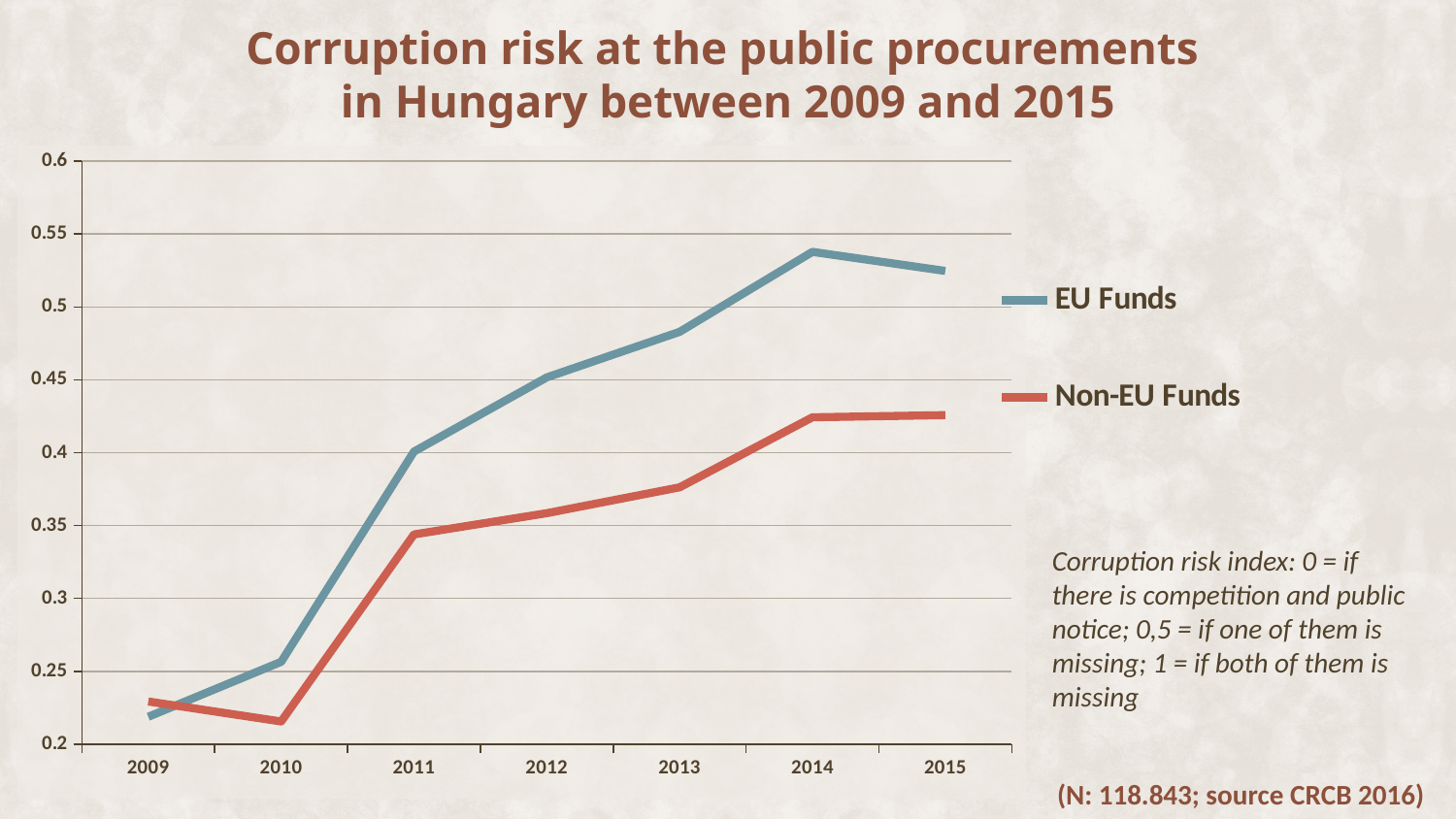
Is the value for Non-EU Funds in 2014 greater or less than 0.45? less Is the value for EU Funds in 2014 greater or less than 0.5? greater In which year is the EU Funds series at its lowest value? 2009 In which year is the Non-EU Funds series at its lowest value? 2010 Is the value for Non-EU Funds in 2013 greater or less than 0.4? less How many years are shown on the x axis? 7 Does the EU Funds series generally rise or fall between 2009 and 2014? rise What kind of chart is shown on the slide? Line chart Which series has the higher value in 2013, EU Funds or Non-EU Funds? EU Funds Which series is drawn in red? Non-EU Funds In which year does the EU Funds series reach its highest value? 2014 How many series does the legend list? 2